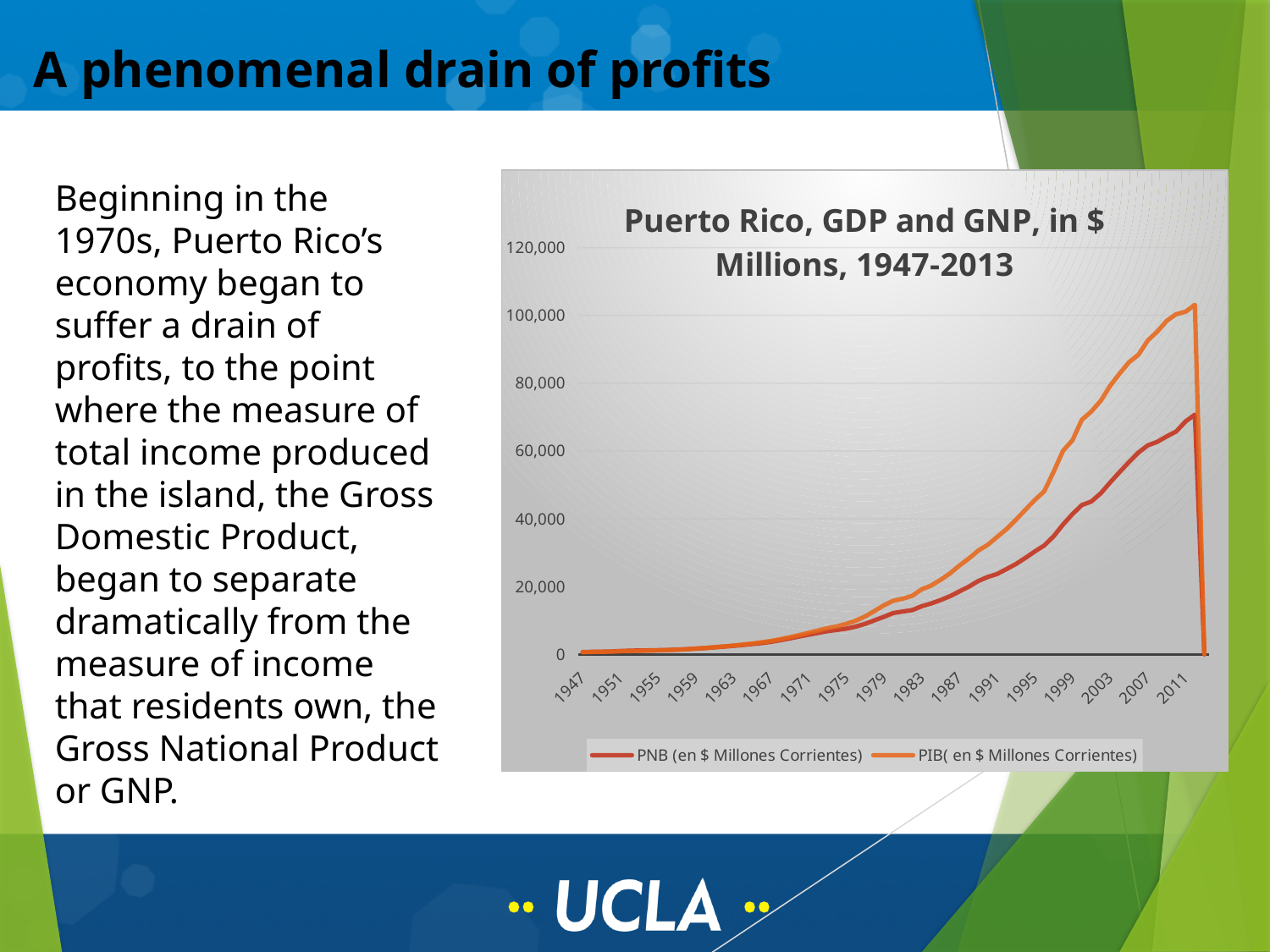
Is the value of PNB (en $ Millones Corrientes) at its peak around 2011 greater or less than 80,000? less In 2007, which series has the higher value, PNB or PIB? PIB Is the value of PIB (en $ Millones Corrientes) at its peak around 2011 greater or less than 80,000? greater What is the title of the chart? Puerto Rico, GDP and GNP, in $ Millions, 1947-2013 Do the values of PIB (en $ Millones Corrientes) generally rise or fall from 1947 to 2011? rise What are the two series named in the chart's legend? PNB (en $ Millones Corrientes) and PIB( en $ Millones Corrientes) How many year labels are shown on the x axis? 17 Is the value of PIB (en $ Millones Corrientes) in 2003 greater or less than 60,000? greater How many series does the chart's legend list? 2 What kind of chart is shown on the slide? line chart